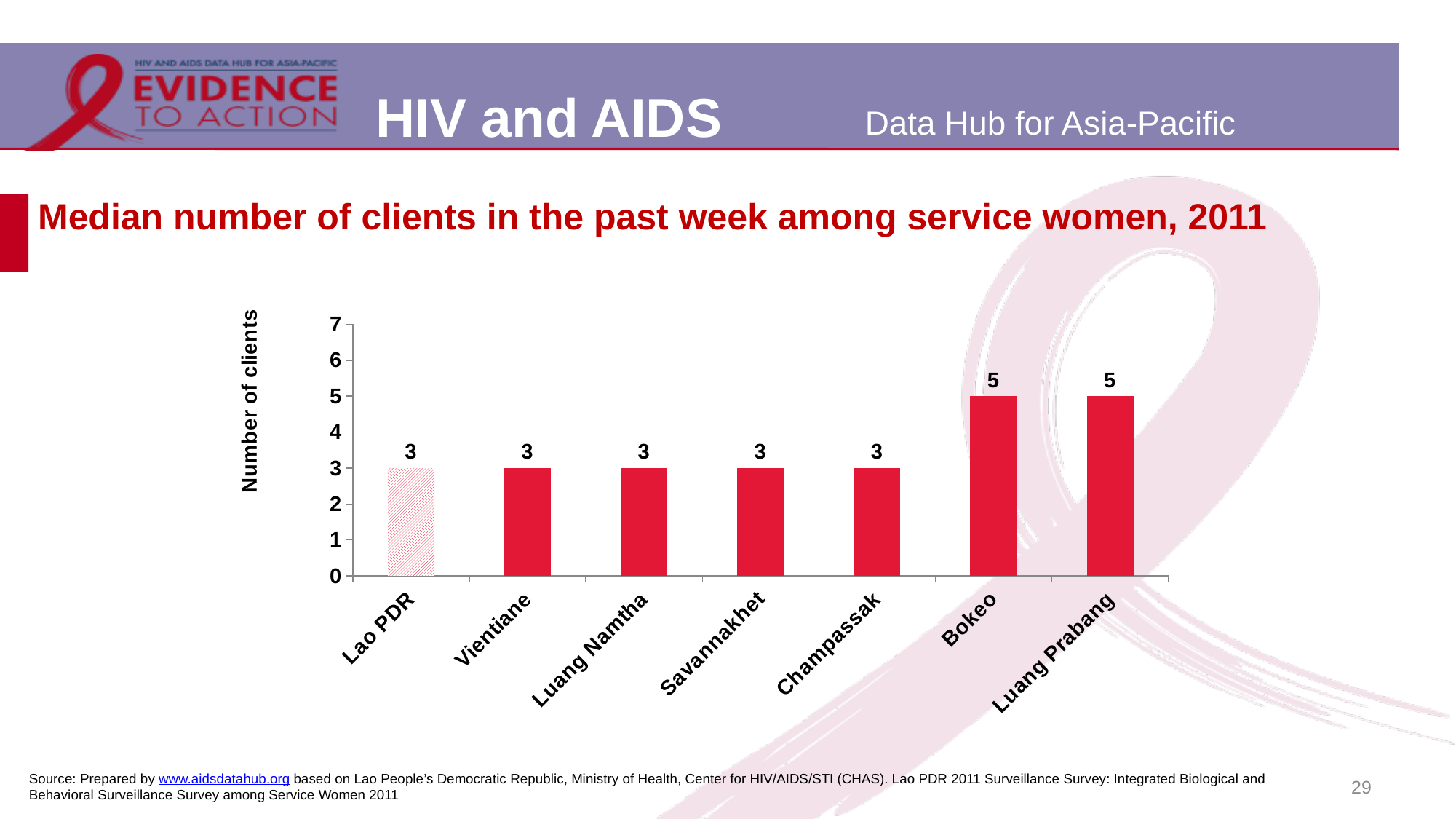
What is the value shown for Lao PDR? 3 What is the median number of clients in the past week for Bokeo? 5 How many categories are shown on the x axis of the chart? 7 Which bar is drawn with a hatched pattern rather than solid fill? Lao PDR What is the difference between the values for Bokeo and Savannakhet? 2 Which has a higher median number of clients, Luang Prabang or Champassak? Luang Prabang What is the value shown for Luang Prabang? 5 What is the median number of clients in the past week for Vientiane? 3 How many provinces have a median of 5 clients? 2 Is the value for Bokeo greater or less than 4? greater What is the label of the y axis? Number of clients What kind of chart is shown on the slide? bar chart